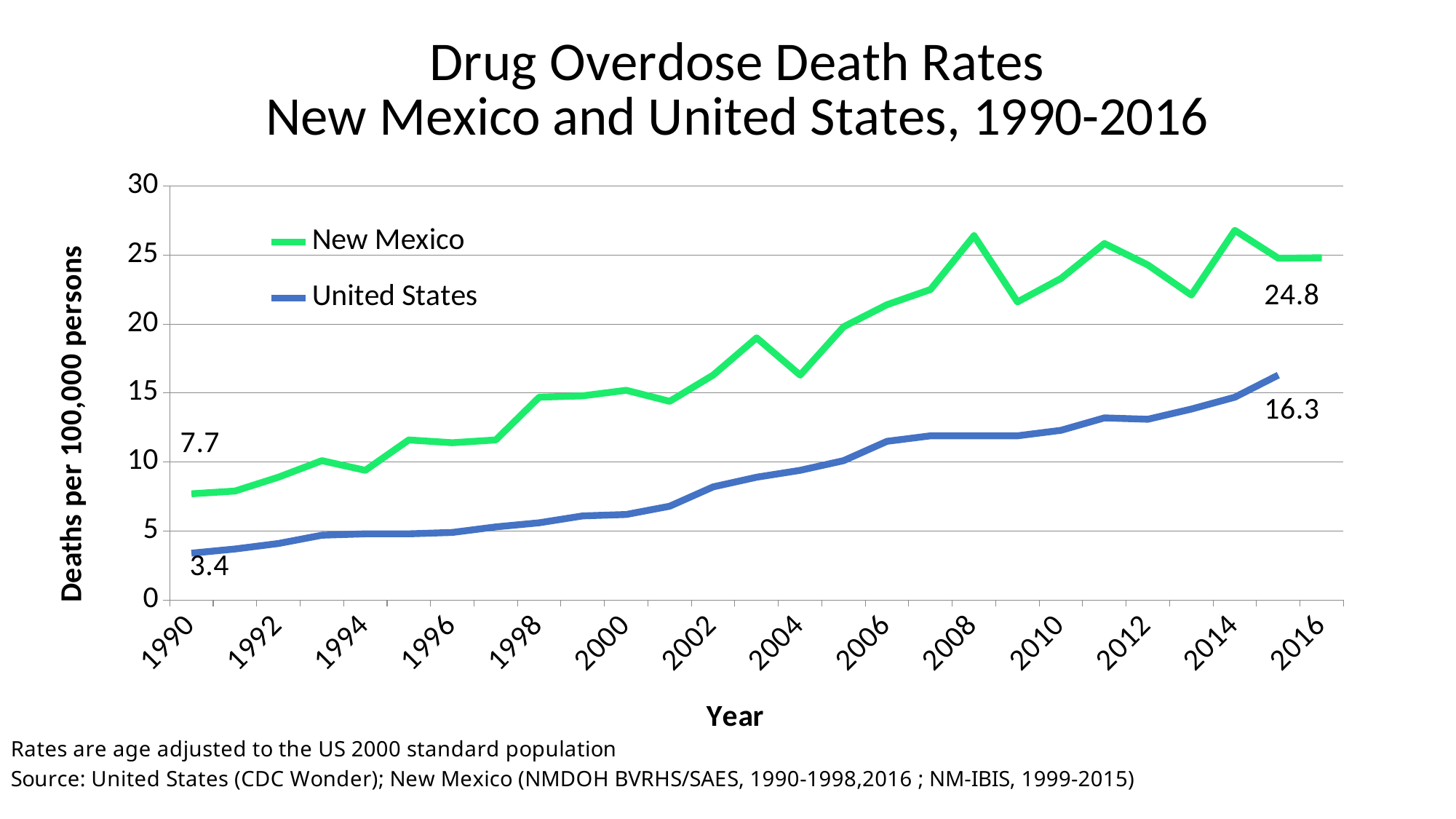
What was the drug overdose death rate for New Mexico in 1990? 7.7 Does the United States line generally rise or fall from 1990 onward? rise In 1990, how much higher was New Mexico's rate than the United States rate? 4.3 By how much did New Mexico's drug overdose death rate increase from 1990 (7.7) to 2016 (24.8)? 17.1 How many series does the legend list? 2 Which had the higher drug overdose death rate in 1990, New Mexico or the United States? New Mexico What is the value labeled at the end of the United States line? 16.3 What is the title of the y axis? Deaths per 100,000 persons What was the drug overdose death rate for the United States in 1990? 3.4 What was the drug overdose death rate for New Mexico in 2016? 24.8 Is the value for New Mexico in 2008 greater or less than 25? greater What kind of chart is shown on the slide? line chart